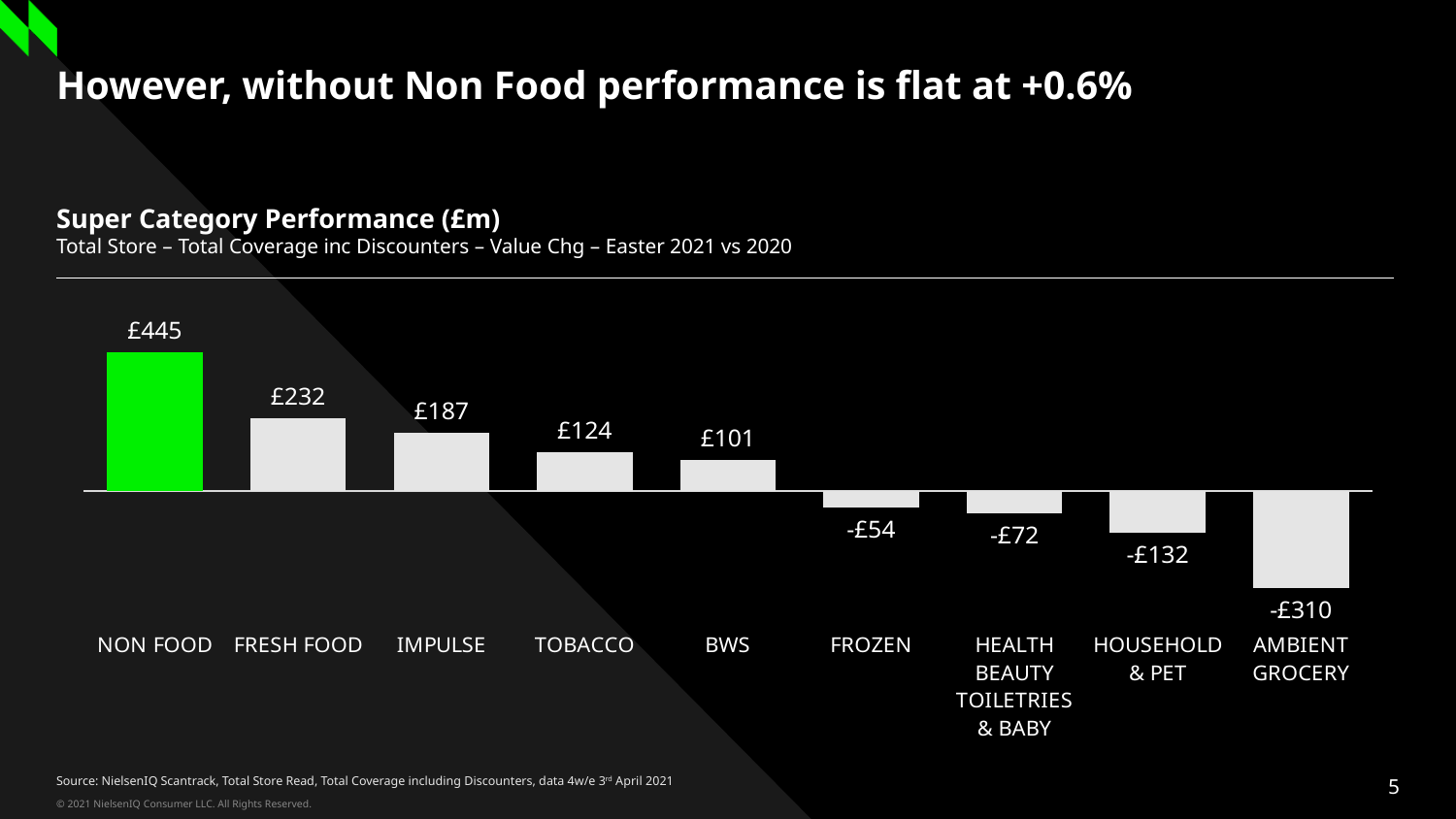
What is the title of the chart? Super Category Performance (£m) Which category has the highest value? NON FOOD What is the difference between the values for NON FOOD and FRESH FOOD? £213 What is the value for HEALTH BEAUTY TOILETRIES & BABY? -£72 Which is larger, the value for FROZEN or the value for HOUSEHOLD & PET? FROZEN How many categories are shown in the chart? 9 What is the difference between the values for IMPULSE and BWS? £86 What kind of chart is shown on the slide? Bar chart Which category has the lowest value? AMBIENT GROCERY What is the value for AMBIENT GROCERY? -£310 What is the value for TOBACCO? £124 What is the value for NON FOOD? £445